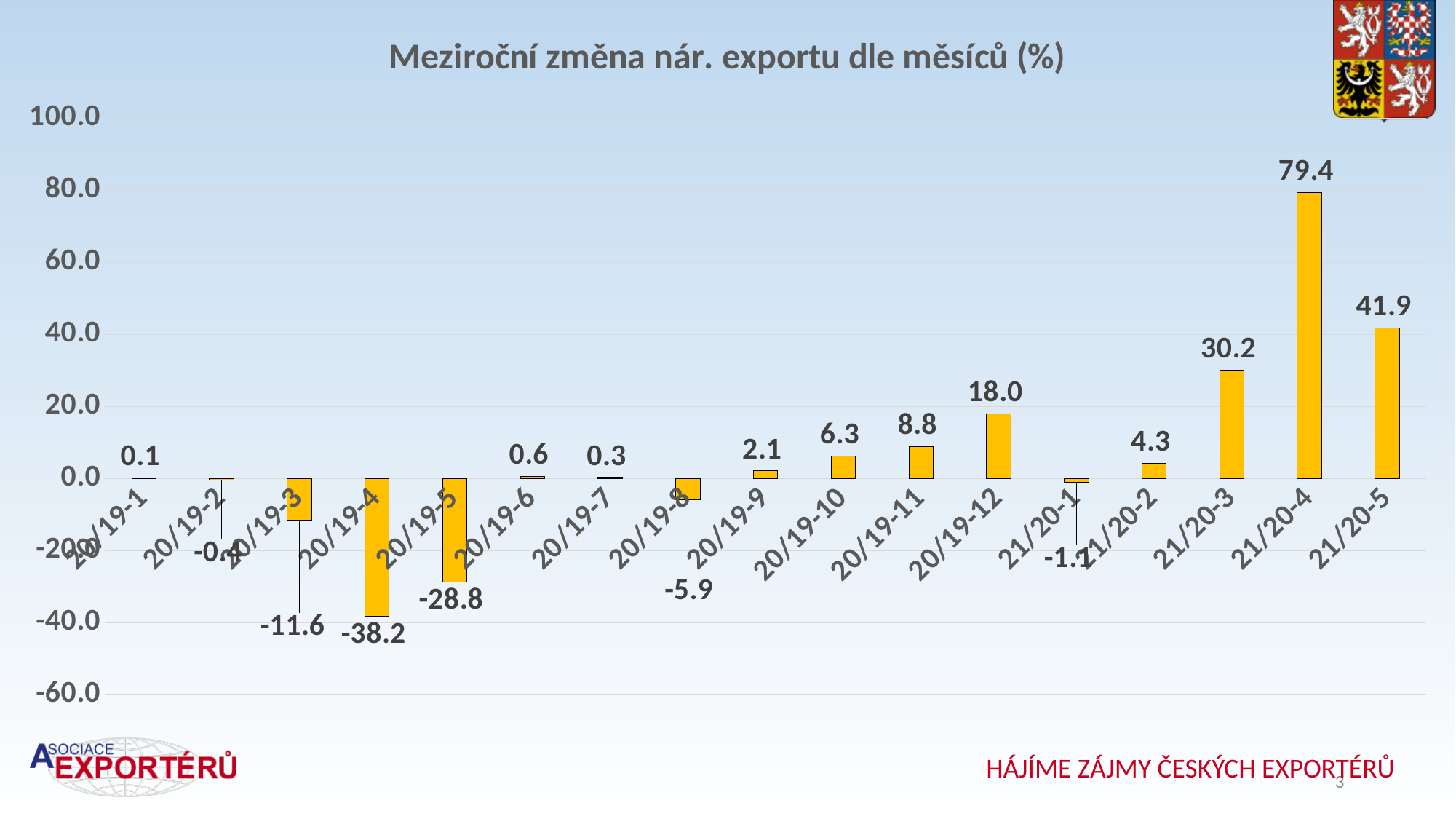
What is the value for 21/20-4? 79.4 What is the value for 20/19-4? -38.2 What is the value for 20/19-8? -5.9 What is the title of the chart? Meziroční změna nár. exportu dle měsíců (%) What kind of chart is this? bar chart Which is larger, the value for 21/20-3 or the value for 20/19-12? 21/20-3 Which month has the lowest value? 20/19-4 How many months are shown on the x axis? 17 What is the difference between the values for 21/20-4 and 21/20-5? 37.5 Which month has the highest value? 21/20-4 What is the value for 20/19-12? 18.0 Is the value for 21/20-5 greater or less than 40.0? greater